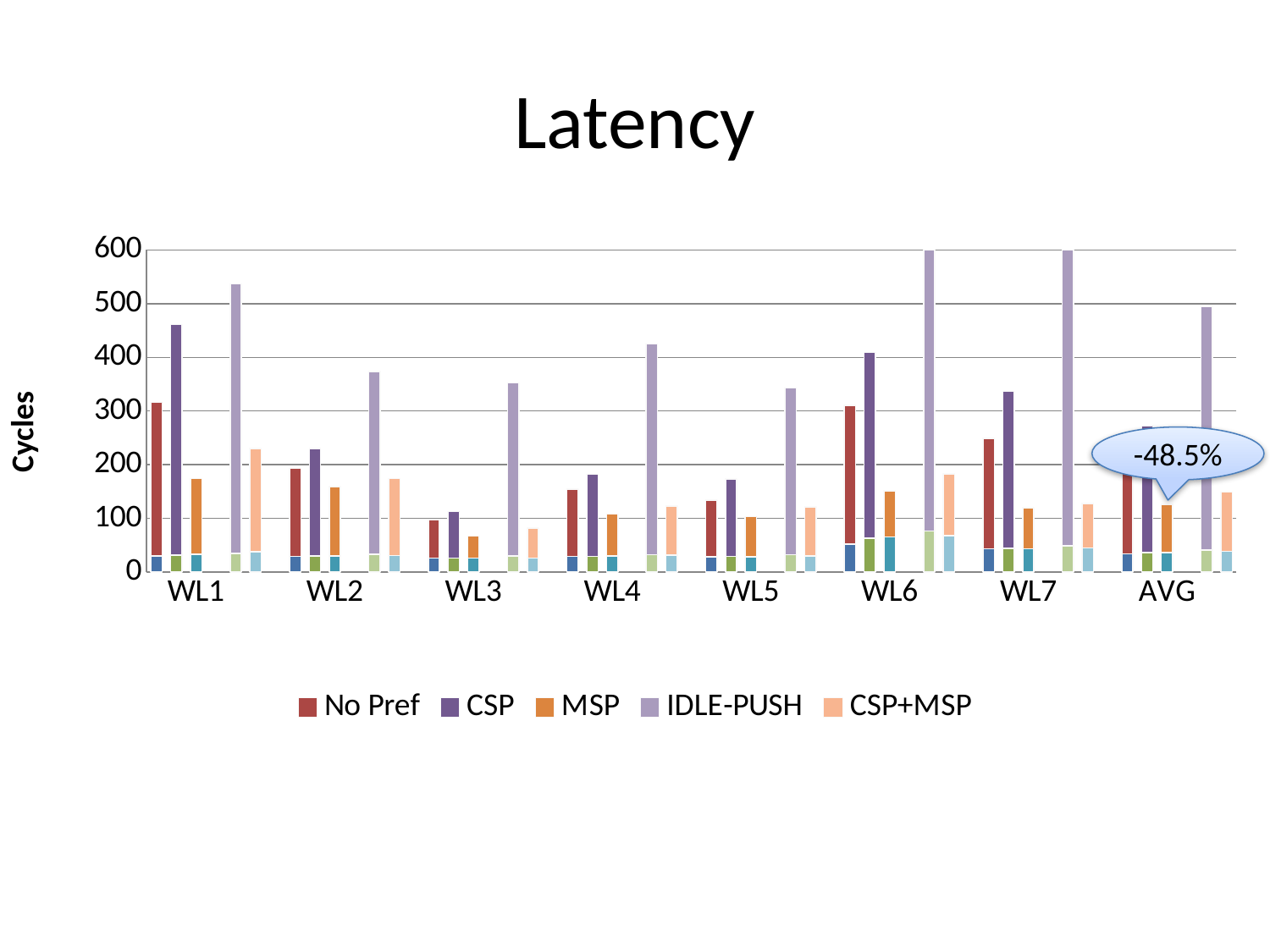
How many series does the legend list? 5 What is the label on the y axis? Cycles Which workload has the lowest No Pref value? WL3 Is the CSP value for WL1 greater or less than 400? greater Is the IDLE-PUSH value for WL2 greater or less than 400? less What type of chart is shown on the slide? bar chart Is the CSP value for WL5 greater or less than 200? less How many categories are shown on the x axis? 8 What is the title of the chart? Latency Which series has the highest value for WL1? IDLE-PUSH